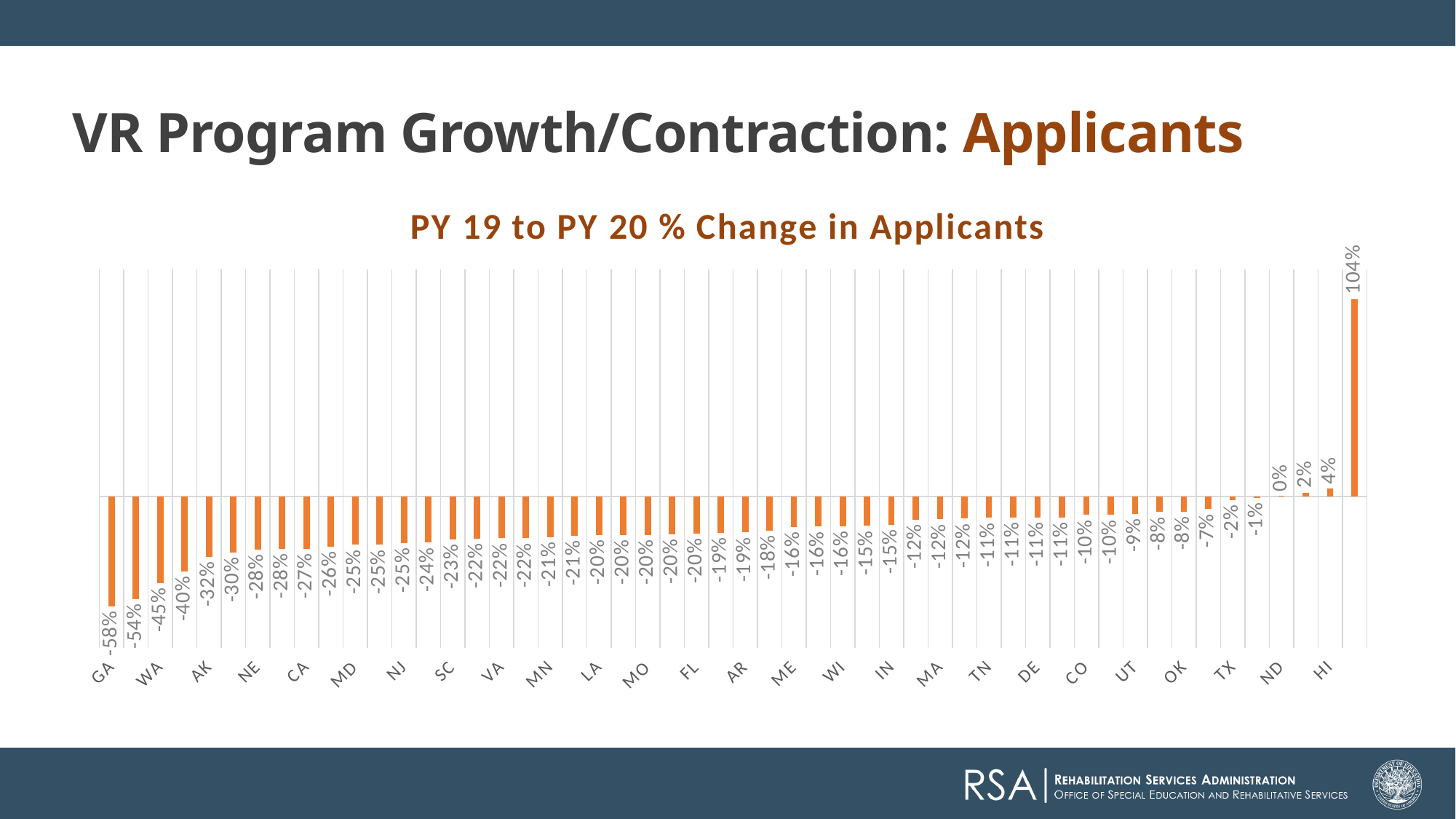
Do the values generally rise or fall moving from left to right along the x axis? Rise What is the % change in applicants for WA? -45% Which state has the lowest % change in applicants? GA Which has a larger % change in applicants, GA or WA? WA What is the % change in applicants for GA? -58% What is the % change in applicants for HI? 4% What is the highest value shown in the chart? 104% What is the % change in applicants for TX? -2% What type of chart is shown on the slide? Bar chart What is the title of the chart? PY 19 to PY 20 % Change in Applicants What is the difference in percentage points between the values for WA (-45%) and GA (-58%)? 13 percentage points What is the % change in applicants for ND? 0%